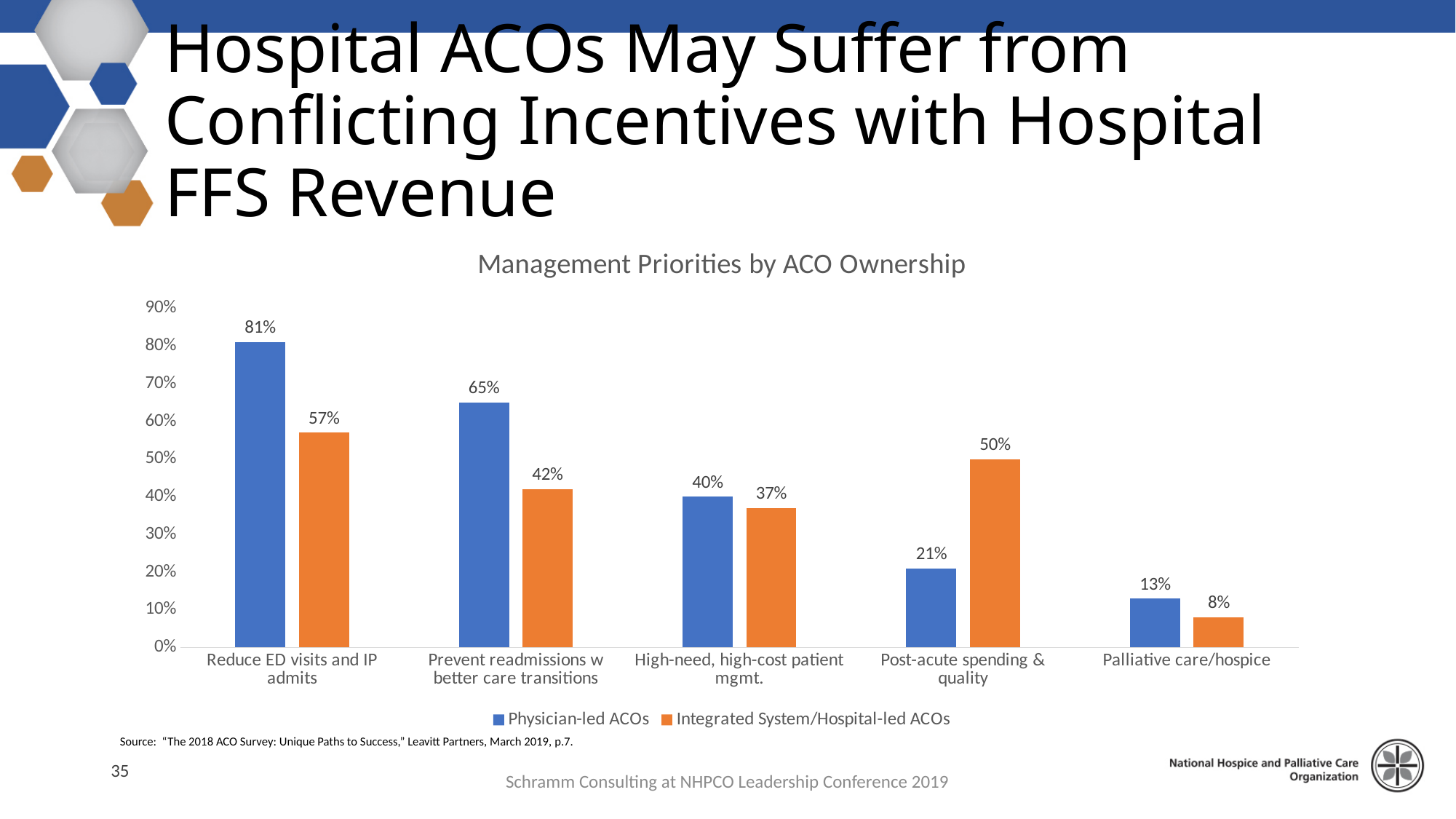
Which category has the lowest value for Integrated System/Hospital-led ACOs? Palliative care/hospice What kind of chart is shown? bar chart How many series does the legend list? 2 What is the value for Integrated System/Hospital-led ACOs for Post-acute spending & quality? 50% Is the value for Physician-led ACOs for High-need, high-cost patient mgmt. greater or less than 30%? greater What is the value for Integrated System/Hospital-led ACOs for Palliative care/hospice? 8% What is the title of the chart? Management Priorities by ACO Ownership For Post-acute spending & quality, which series has the larger value? Integrated System/Hospital-led ACOs Which category has the highest value for Physician-led ACOs? Reduce ED visits and IP admits How many categories are shown on the x axis? 5 What is the difference between Physician-led ACOs and Integrated System/Hospital-led ACOs for Prevent readmissions w better care transitions? 23% What is the value for Physician-led ACOs for Reduce ED visits and IP admits? 81%